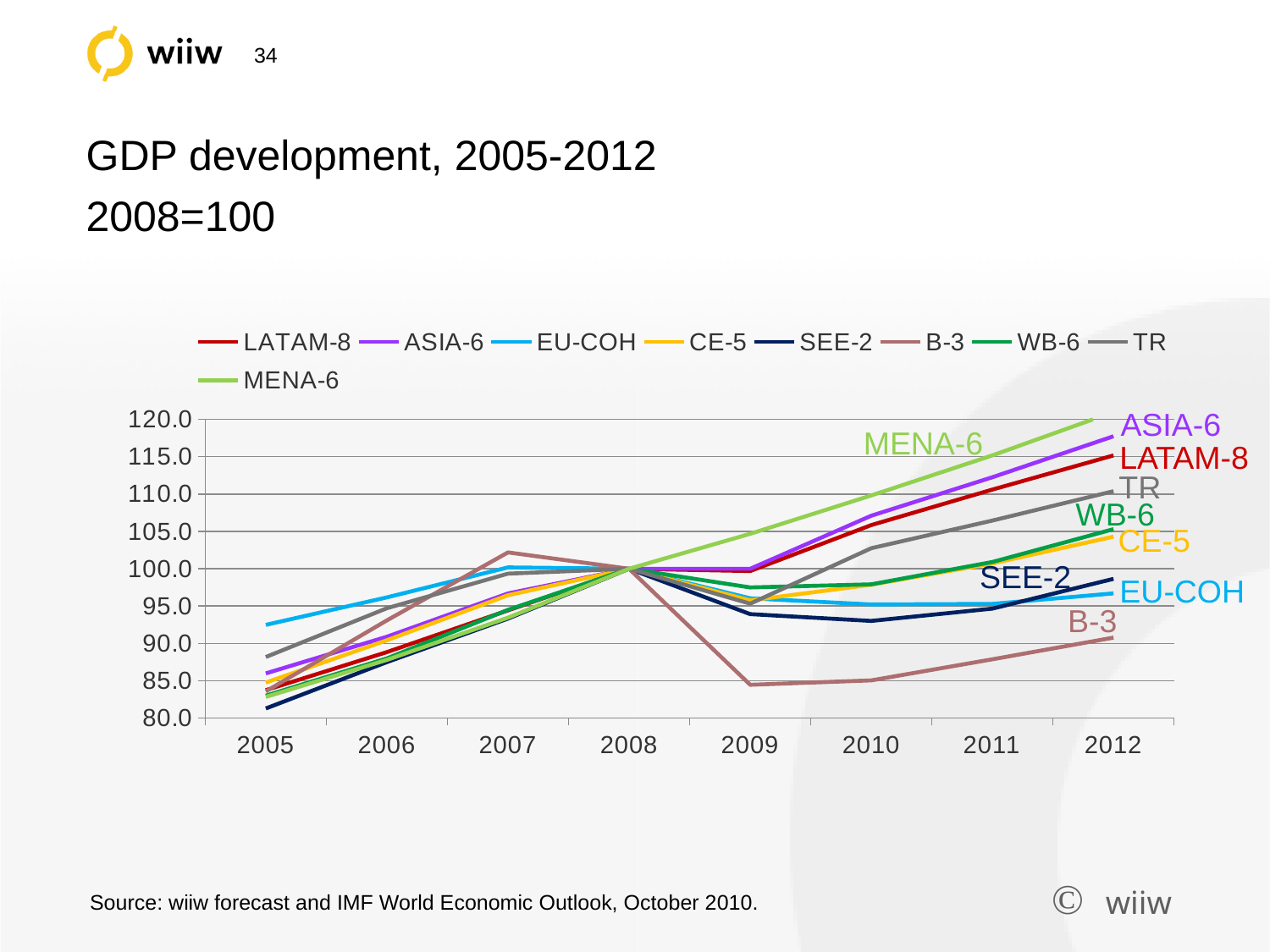
Is the value for ASIA-6 in 2012 greater or less than 115? greater Is the value for SEE-2 in 2010 greater or less than 95? less Which is larger in 2012, ASIA-6 or TR? ASIA-6 What kind of chart is shown on the slide? line chart Which series has the highest value in 2012? MENA-6 How many series does the legend list? 9 How many years are shown along the x axis? 8 Is the value for B-3 in 2009 greater or less than 90? less Which series has the lowest value in 2012? B-3 Does the B-3 line rise or fall from 2009 to 2012? rise What is the value of every series in 2008? 100.0 Which series has the lowest value in 2009? B-3